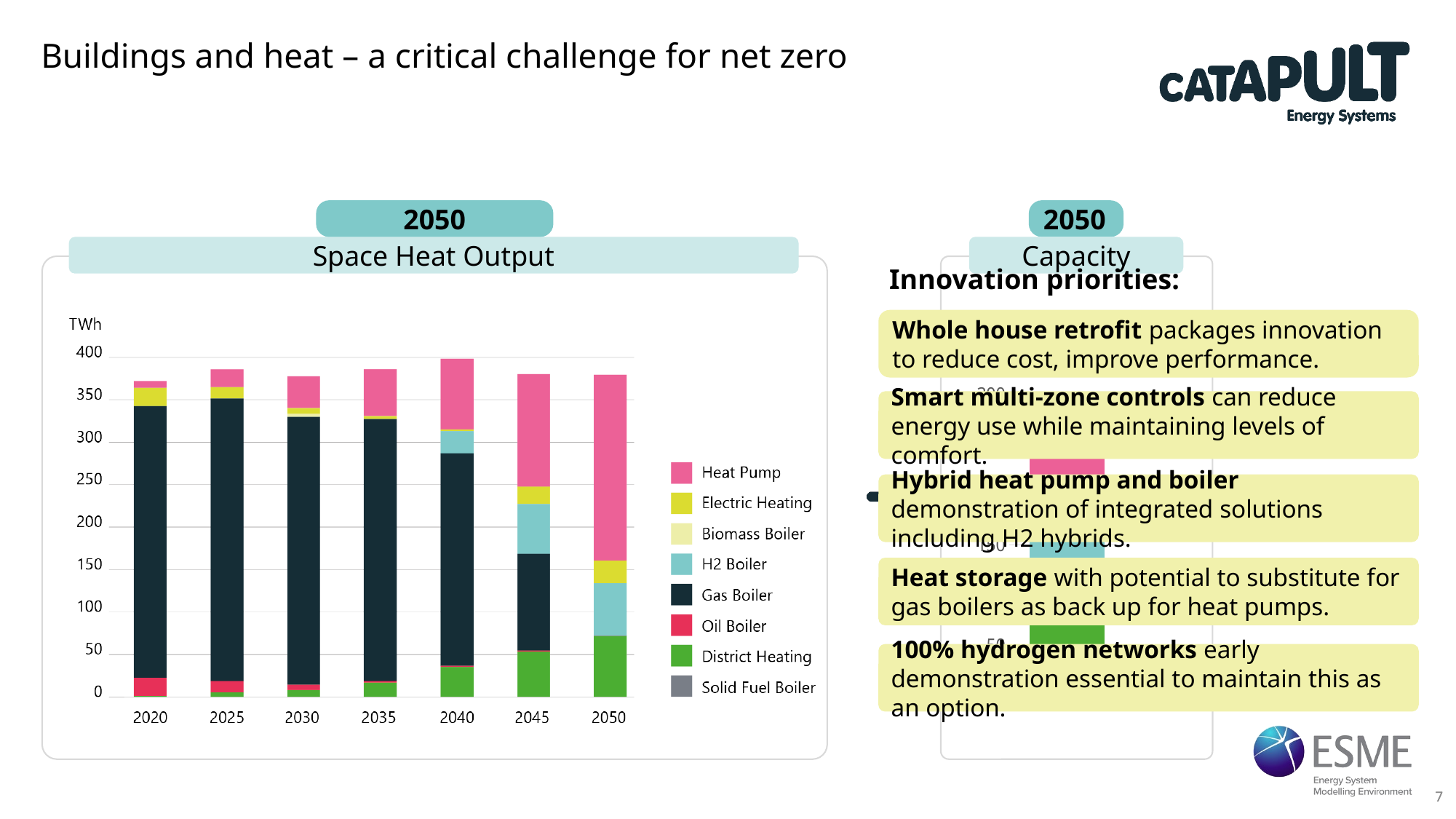
What unit is shown on the y axis of the Space Heat Output chart? TWh In the Space Heat Output chart, is the total for 2050 greater or less than 400? less In the Space Heat Output chart, is the District Heating value for 2050 greater or less than 50? greater In the Space Heat Output chart, which year has the largest District Heating segment? 2050 In the Space Heat Output chart, does the Heat Pump segment rise or fall from 2020 to 2050? Rise What kind of chart is the Space Heat Output chart? Stacked bar chart In the Space Heat Output chart, which series is shown in dark navy? Gas Boiler How many years are shown on the x axis of the Space Heat Output chart? 7 In the Space Heat Output chart, is the Gas Boiler segment larger in 2020 or in 2045? 2020 In the Space Heat Output chart, which year has the largest Heat Pump segment? 2050 In the Space Heat Output chart, is the total for 2020 greater or less than 350? greater How many series does the legend of the Space Heat Output chart list? 8